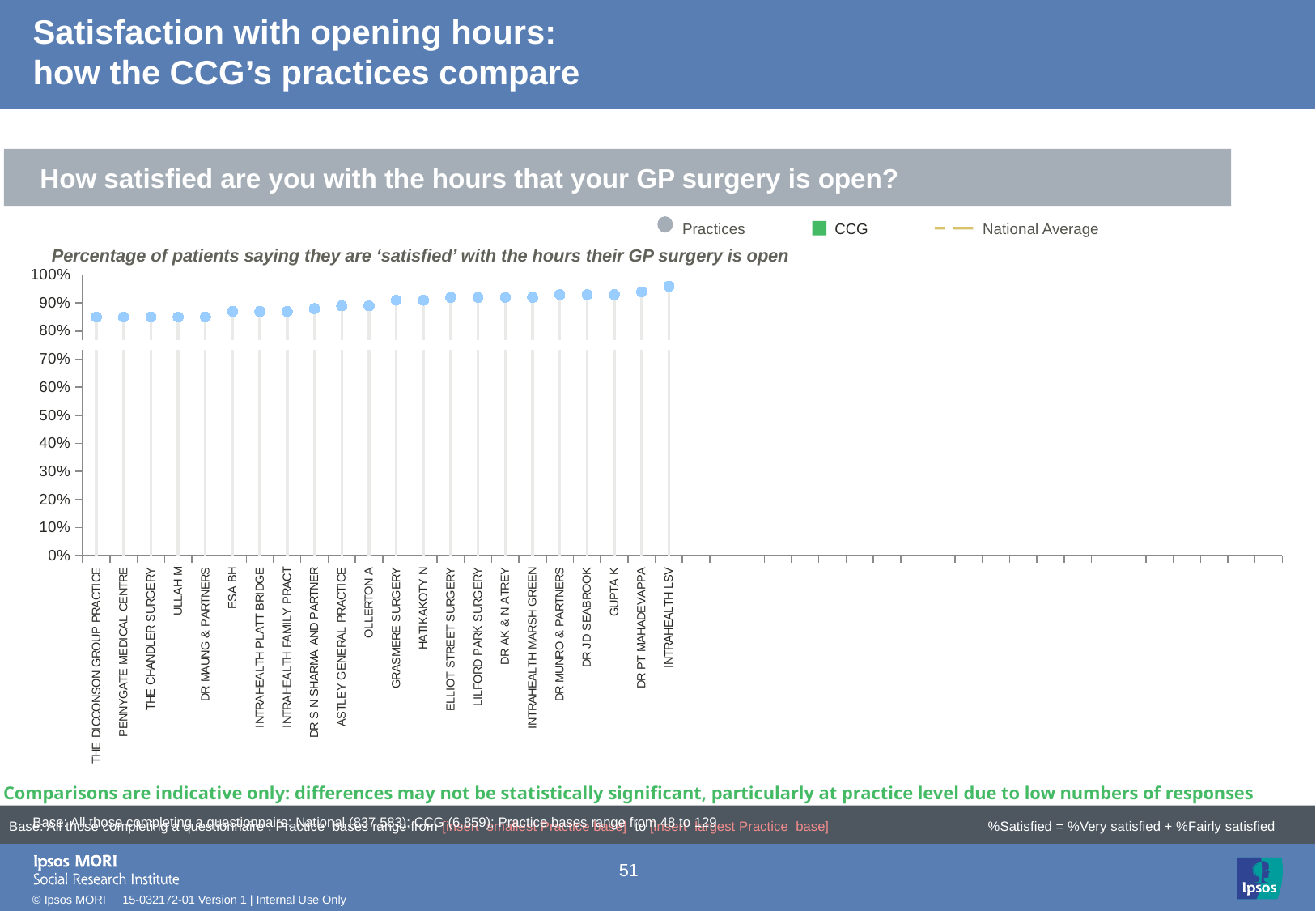
Is the value for ESA BH greater or less than 90%? less How many entries does the chart legend list? 3 How many practices are plotted on the chart? 22 Which has the higher value, INTRAHEALTH LSV or THE DICCONSON GROUP PRACTICE? INTRAHEALTH LSV Is the value for INTRAHEALTH LSV greater or less than 90%? greater Which practice has the highest percentage of patients satisfied with opening hours? INTRAHEALTH LSV Is the value for THE DICCONSON GROUP PRACTICE greater or less than 90%? less What is the question shown above the chart? How satisfied are you with the hours that your GP surgery is open? Which has the higher value, DR PT MAHADEVAPPA or ESA BH? DR PT MAHADEVAPPA What colour is the CCG marker in the legend? green Do the plotted values rise or fall from left to right along the x axis? rise